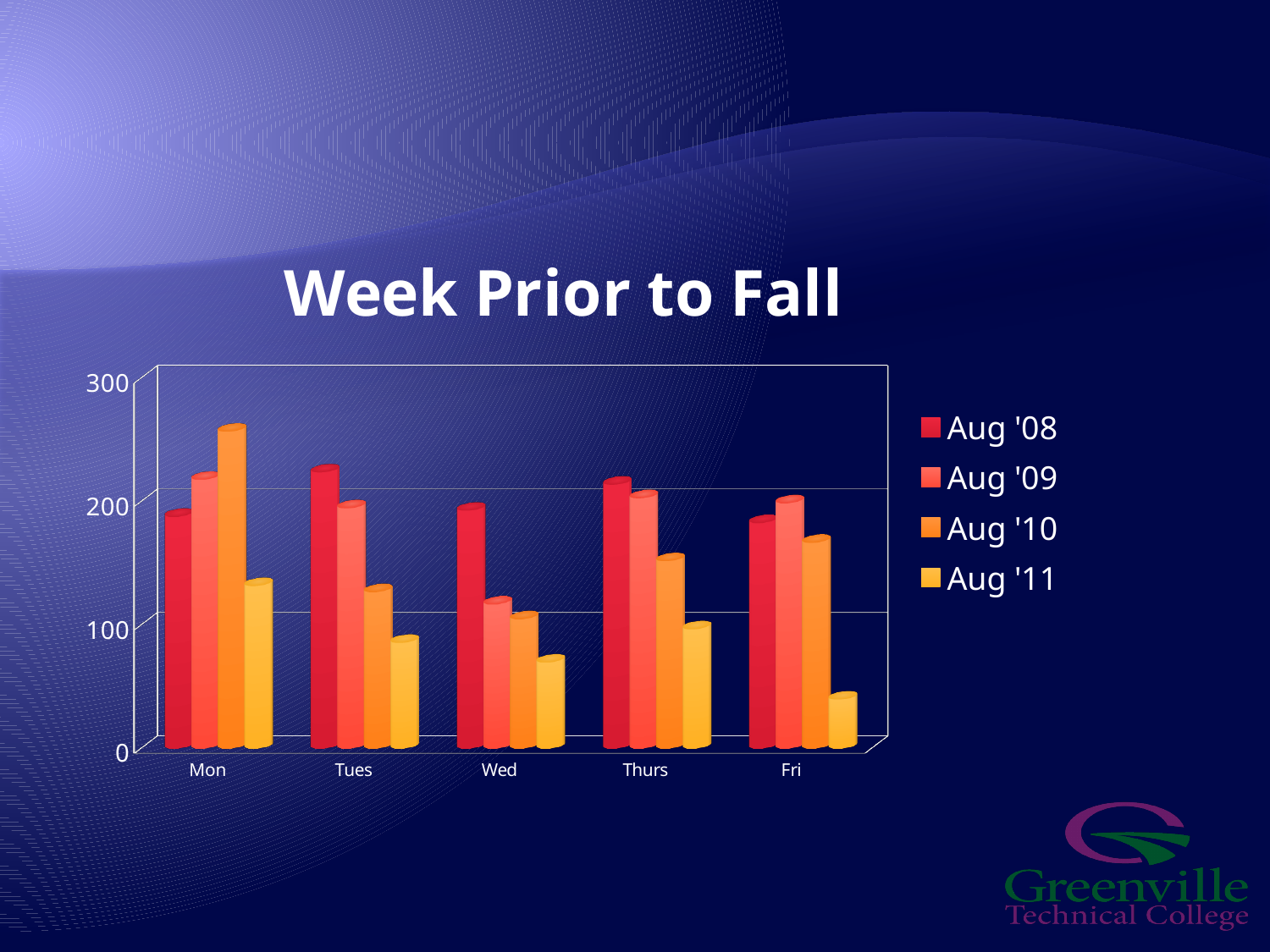
How many categories are shown on the x axis? 5 Is the value for Aug '10 on Thurs greater or less than 200? less What kind of chart is shown on the slide? bar chart On Mon, which is larger: the Aug '08 value or the Aug '10 value? Aug '10 On which day is the Aug '11 value highest? Mon Is the value for Aug '10 on Mon greater or less than 200? greater How many series does the legend list? 4 Is the value for Aug '11 on Mon greater or less than 100? greater What is the title of the chart? Week Prior to Fall On which day is the Aug '11 value lowest? Fri On which day is the Aug '09 value lowest? Wed